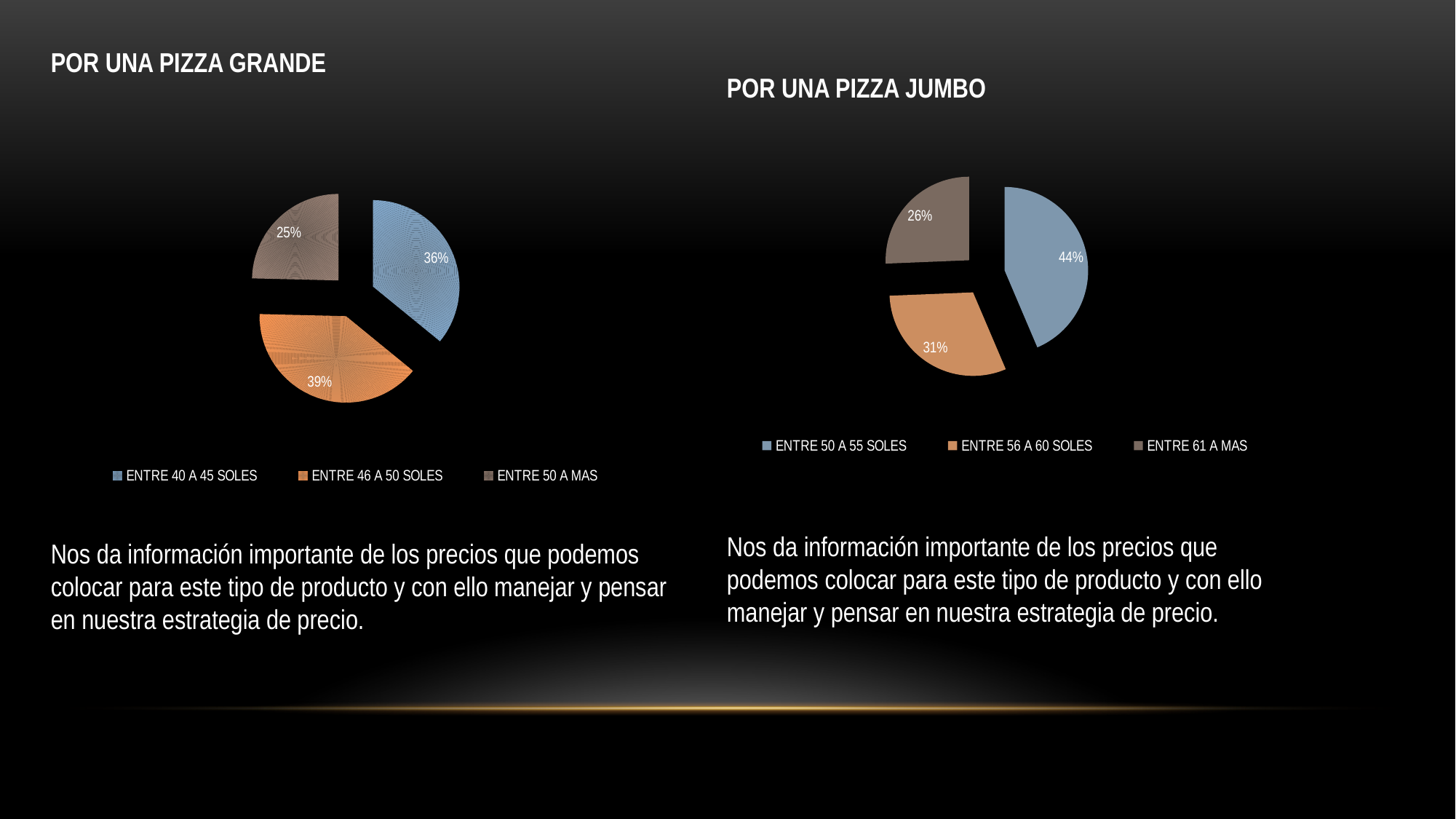
In the 'POR UNA PIZZA GRANDE' chart, which category has the largest slice? ENTRE 46 A 50 SOLES In the 'POR UNA PIZZA GRANDE' chart, what share is labelled for ENTRE 46 A 50 SOLES? 39% How many categories does the 'POR UNA PIZZA JUMBO' chart show? 3 In the 'POR UNA PIZZA JUMBO' chart, what share is labelled for ENTRE 50 A 55 SOLES? 44% In the 'POR UNA PIZZA GRANDE' chart, what share is labelled for ENTRE 40 A 45 SOLES? 36% In the 'POR UNA PIZZA JUMBO' chart, which is larger: ENTRE 56 A 60 SOLES or ENTRE 61 A MAS? ENTRE 56 A 60 SOLES In the 'POR UNA PIZZA JUMBO' chart, which category has the largest slice? ENTRE 50 A 55 SOLES In the 'POR UNA PIZZA JUMBO' chart, what share is labelled for ENTRE 61 A MAS? 26% In the 'POR UNA PIZZA GRANDE' chart, what is the difference in percentage points between ENTRE 46 A 50 SOLES and ENTRE 50 A MAS? 14 What kind of chart is the 'POR UNA PIZZA GRANDE' chart? Pie chart In the 'POR UNA PIZZA GRANDE' chart, which category has the smallest slice? ENTRE 50 A MAS In the 'POR UNA PIZZA JUMBO' chart, what is the difference in percentage points between ENTRE 50 A 55 SOLES and ENTRE 56 A 60 SOLES? 13